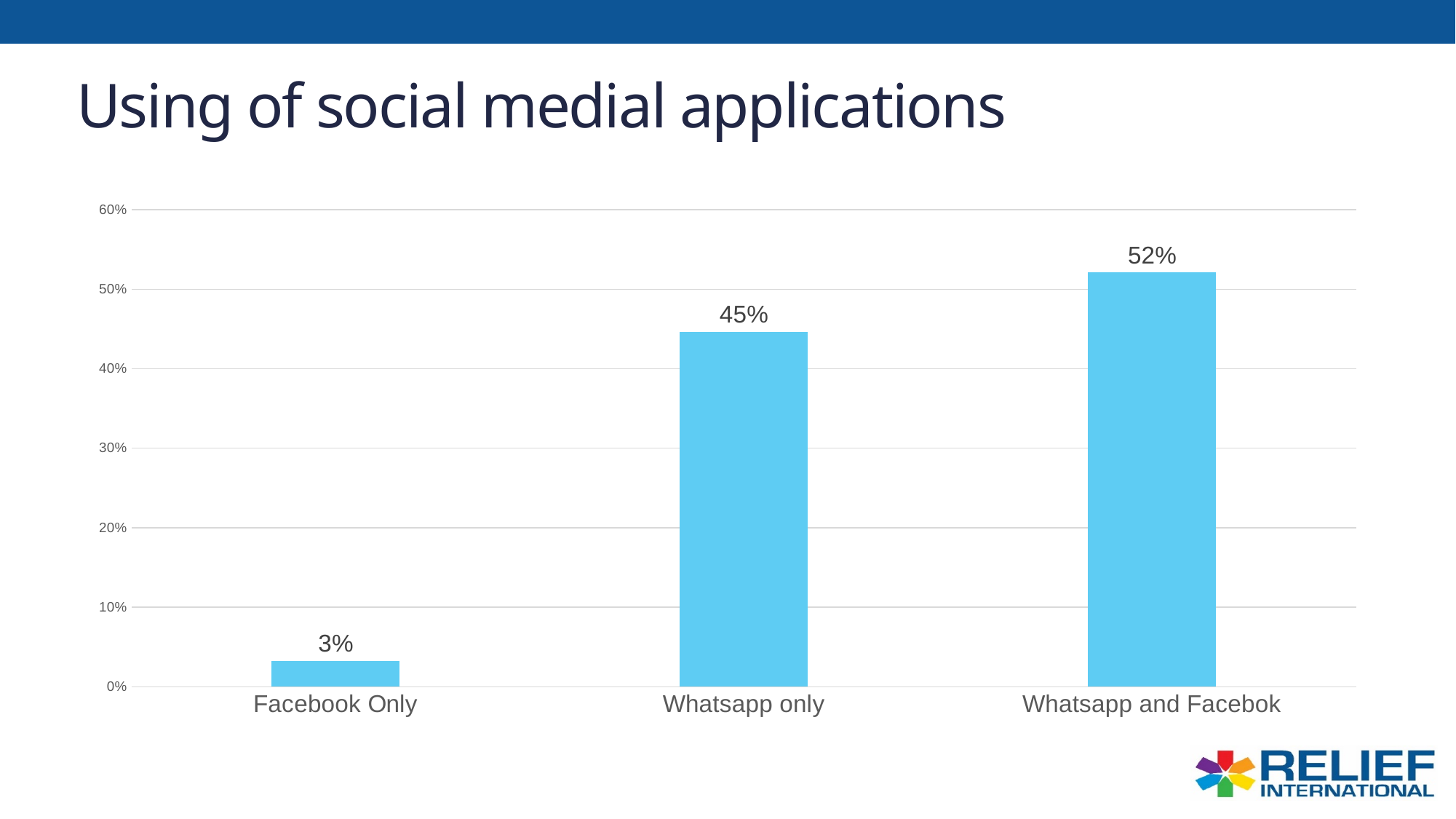
What is the difference between the values for Whatsapp and Facebok and Whatsapp only? 7% What is the value for Whatsapp and Facebok? 52% Which category has the highest value? Whatsapp and Facebok Which category has the lowest value? Facebook Only What kind of chart is shown on the slide? bar chart Which is larger, the value for Whatsapp only or the value for Facebook Only? Whatsapp only Is the value for Whatsapp and Facebok greater or less than 50%? greater What is the title of the slide? Using of social medial applications How many categories are shown on the chart? 3 What is the difference between the values for Whatsapp only and Facebook Only? 42% What is the value for Facebook Only? 3% What is the value for Whatsapp only? 45%